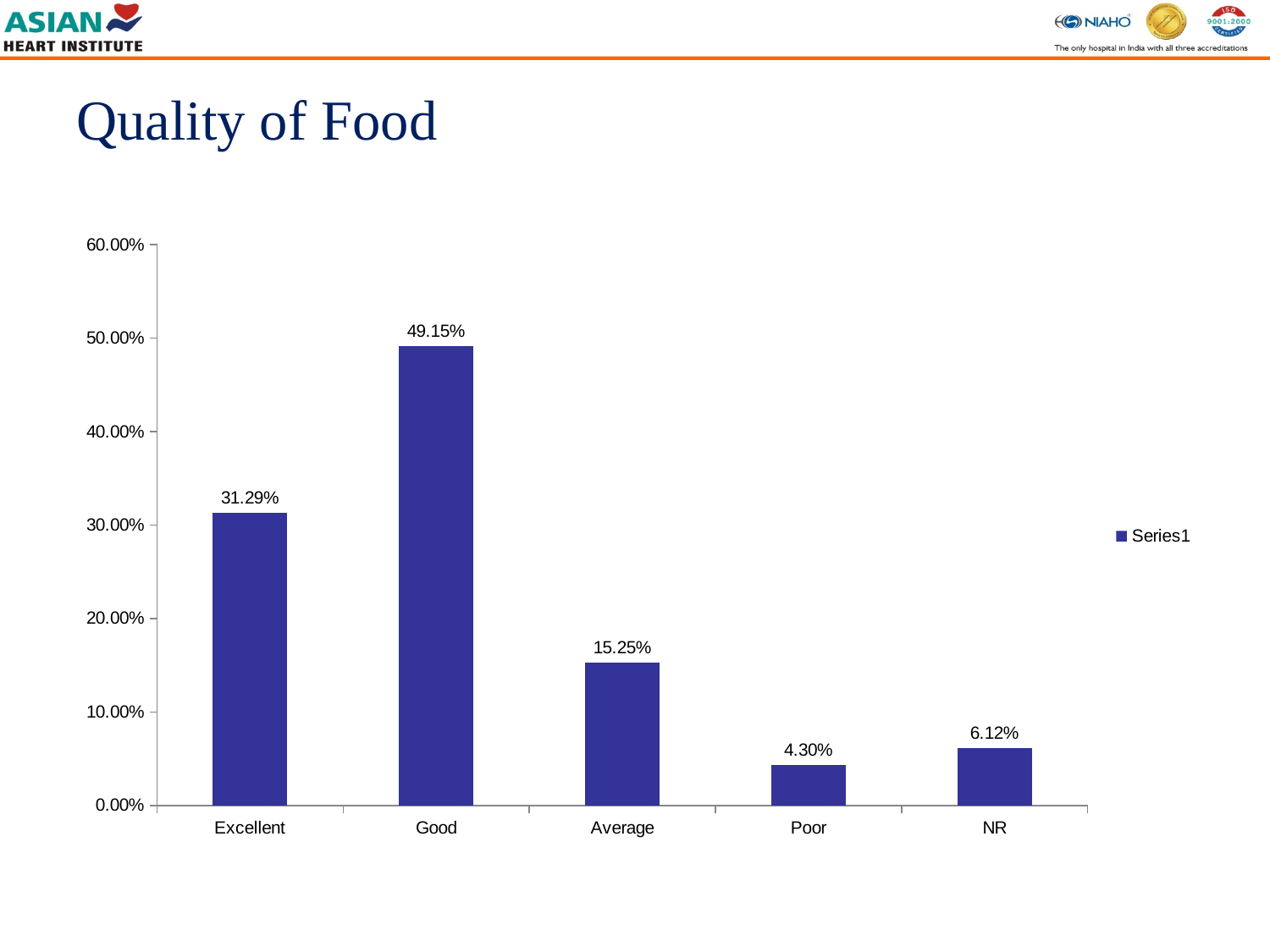
What is the value for NR? 6.12% What kind of chart is shown on the slide? bar chart Which category has the highest value? Good Which is larger, the value for Average or the value for NR? Average What is the value for Good? 49.15% Is the value for Average greater or less than 20.00%? less Which category has the lowest value? Poor What is the value for Excellent? 31.29% How many categories are shown on the x axis? 5 What is the difference between the values for Good and Excellent? 17.86% What is the title of the slide containing the chart? Quality of Food What is the value for Poor? 4.30%